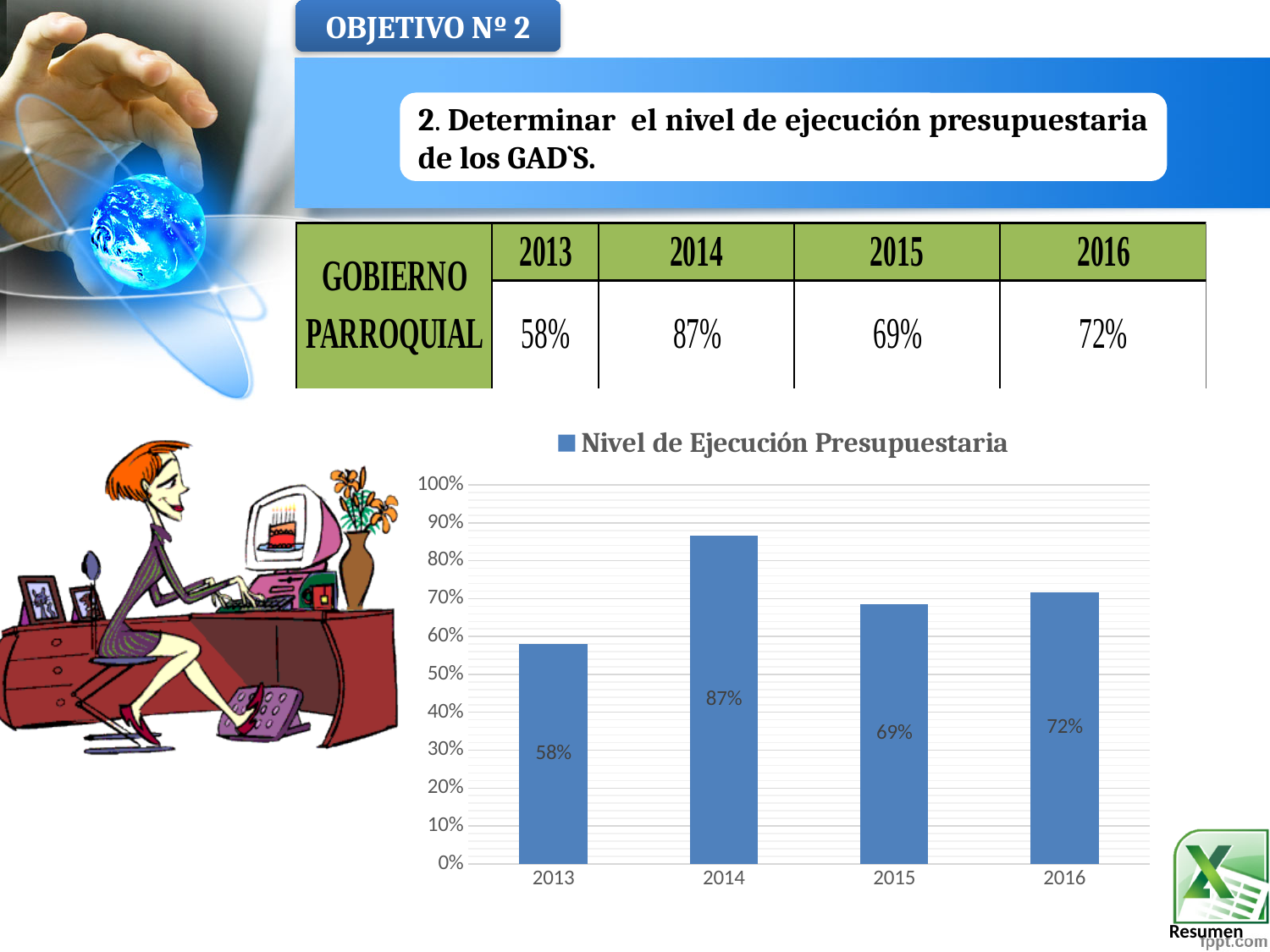
How many years are shown on the x axis of the chart? 4 What is the value for 2016 in the chart? 72% What kind of chart is shown on the slide? bar chart What series name does the chart legend show? Nivel de Ejecución Presupuestaria What is the difference between the values for 2014 and 2013? 29% What is the value for 2013 in the chart? 58% Is the value for 2014 greater or less than 80%? greater Which year has the lowest value in the chart? 2013 Which year has the highest value in the chart? 2014 What is the value for 2014 in the chart? 87% What is the value for 2015 in the chart? 69% Which is larger, the value for 2015 or the value for 2016? 2016